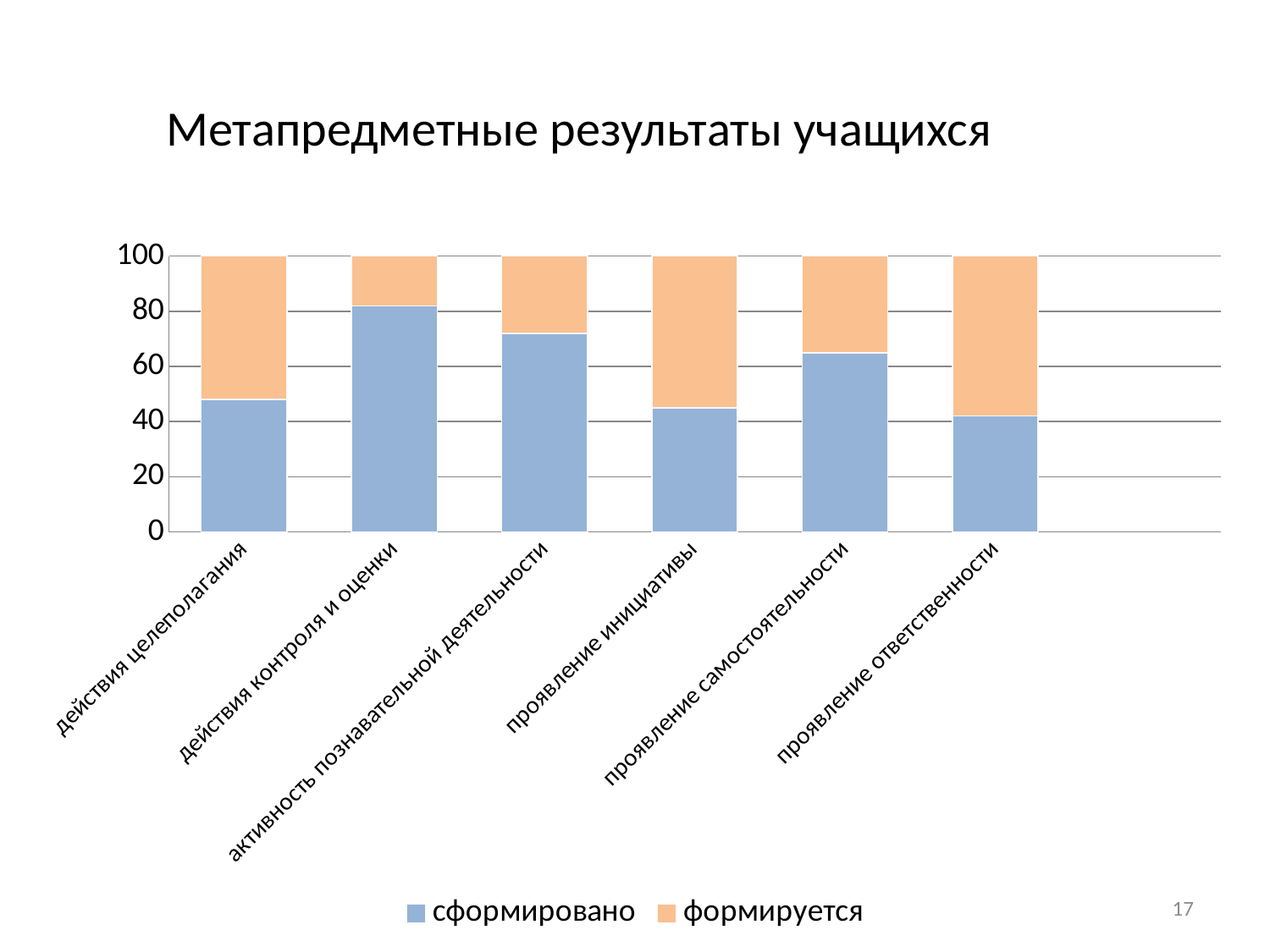
Which is larger, the сформировано value for действия контроля и оценки or for проявление инициативы? действия контроля и оценки Is the value for сформировано in проявление ответственности greater or less than 60? less Which category has the highest value for сформировано? действия контроля и оценки What is the title of the chart? Метапредметные результаты учащихся What kind of chart is shown on the slide? stacked bar chart Which category has the lowest value for формируется? действия контроля и оценки Is the value for сформировано in действия целеполагания greater or less than 60? less Is the value for сформировано in активность познавательной деятельности greater or less than 60? greater How many series does the legend list? 2 How many categories are shown on the x axis of the chart? 6 What is the total height of the stacked bar for действия целеполагания? 100